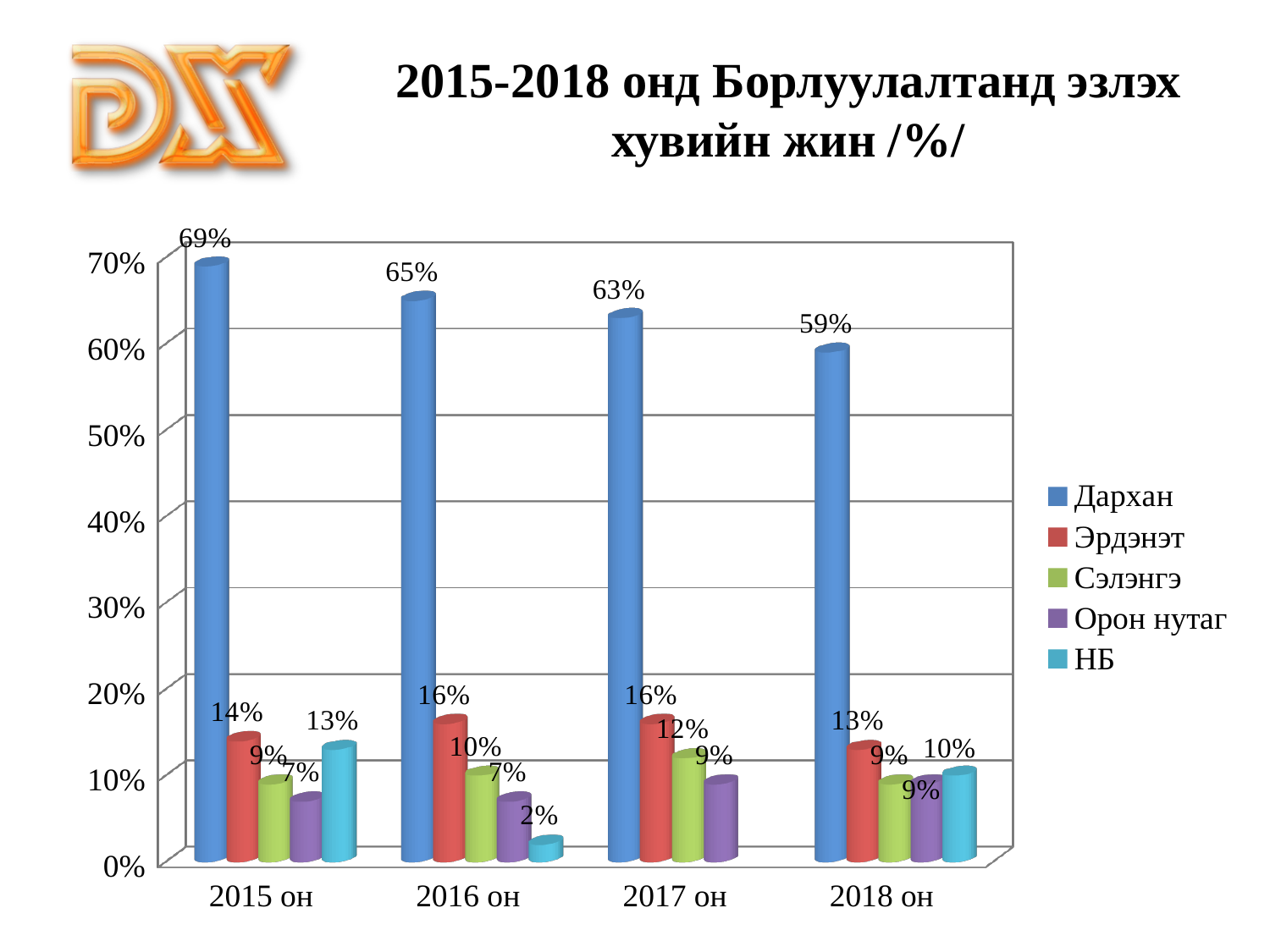
What is the value for Дархан in 2015 он? 69% What is the value for Сэлэнгэ in 2017 он? 12% How many series does the legend list? 5 What is the value for Эрдэнэт in 2016 он? 16% What kind of chart is shown on the slide? bar chart In which year is the Дархан value lowest? 2018 он What is the value for НБ in 2016 он? 2% How many year categories are shown on the x axis? 4 Which is larger in 2015 он, the value for Эрдэнэт or the value for НБ? Эрдэнэт In which year is the Дархан value highest? 2015 он Does the Дархан value rise or fall from 2015 он to 2018 он? fall What is the difference between the Дархан values for 2015 он and 2018 он? 10%